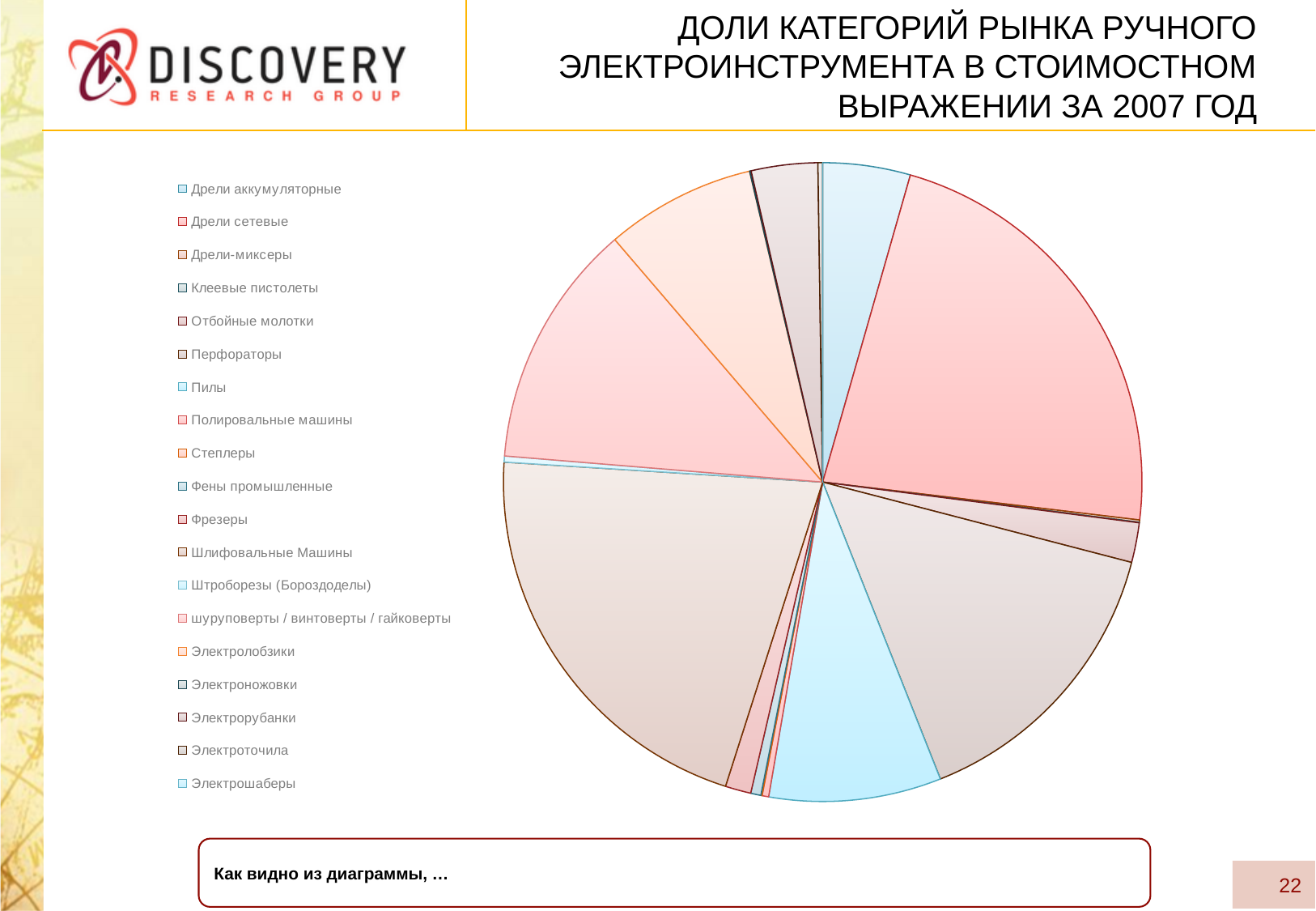
Which category has the largest slice in the pie chart? Дрели сетевые How many categories does the legend of the pie chart list? 19 What kind of chart is shown on the slide? pie chart What is the first category listed in the chart legend? Дрели аккумуляторные Which year does the chart title say the market shares refer to? 2007